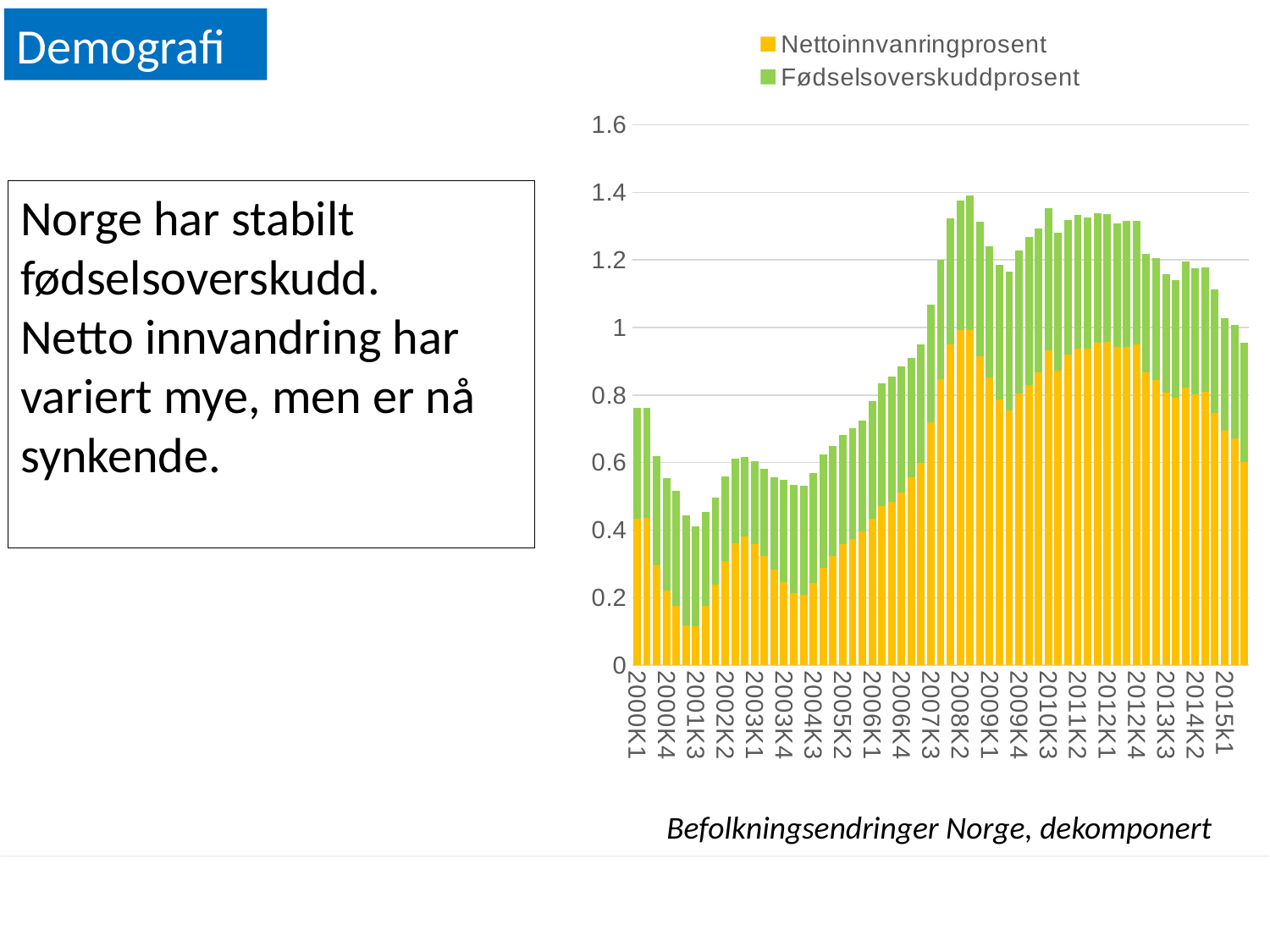
Is the Nettoinnvanringprosent value for 2001K3 greater or less than 0.2? less Which series is shown in green in the chart? Fødselsoverskuddprosent Is the Nettoinnvanringprosent value for 2008K2 greater or less than 0.8? greater Is the total stacked value for 2014K2 greater or less than 1? greater Does the total stacked value rise or fall from 2012K1 to 2015K1? fall Which has the larger total stacked value, 2008K2 or 2001K3? 2008K2 How many series does the chart legend list? 2 What caption appears below the chart? Befolkningsendringer Norge, dekomponert What kind of chart is shown on the slide? stacked bar chart